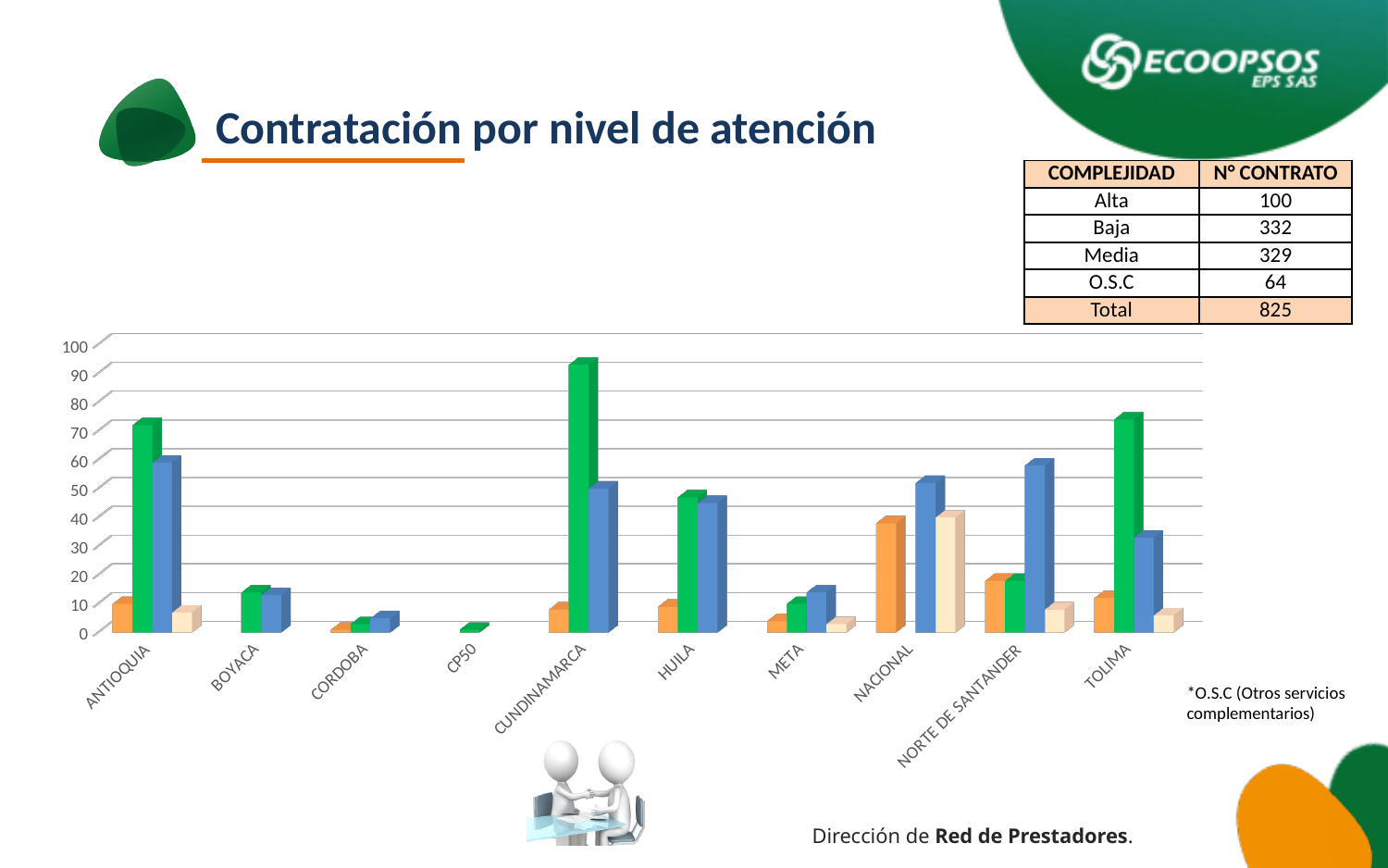
Is the green bar for CUNDINAMARCA greater or less than 80? greater What kind of chart is shown on the slide? bar chart Is the green bar for BOYACA greater or less than 20? less Is the blue bar for NORTE DE SANTANDER greater or less than 50? greater What is the title of the slide containing the chart? Contratación por nivel de atención How many categories are shown along the x axis of the chart? 10 Which is larger, the blue bar for NACIONAL or the blue bar for META? NACIONAL Which is larger, the green bar for CUNDINAMARCA or the green bar for HUILA? CUNDINAMARCA What is the highest value shown on the chart's vertical axis? 100 Which category has the tallest bar in the chart? CUNDINAMARCA